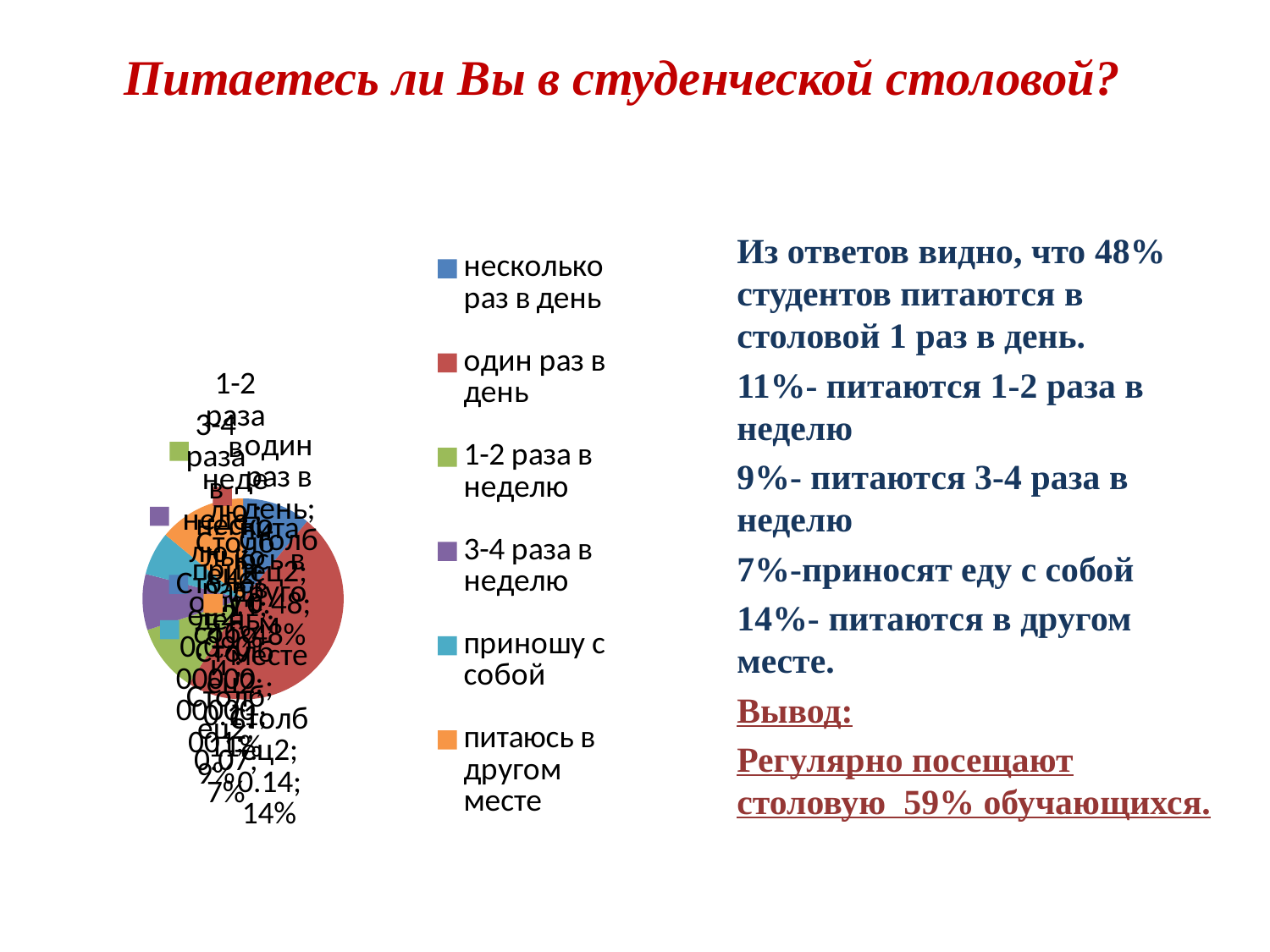
What kind of chart is shown on the slide? pie chart What is the difference in percentage points between 'один раз в день' (48%) and 'питаюсь в другом месте' (14%)? 34 What is the title of the slide containing the pie chart? Питаетесь ли Вы в студенческой столовой? What is the value shown for the category 'один раз в день'? 48% Which category has the largest slice of the pie chart? один раз в день What is the value shown for the category 'питаюсь в другом месте'? 14% What share of the pie does the 'один раз в день' slice represent? 48% Which is larger: the slice for 'один раз в день' or the slice for 'питаюсь в другом месте'? один раз в день What colour is the slice for 'один раз в день' in the pie chart? red How many categories does the legend of the pie chart list? 6